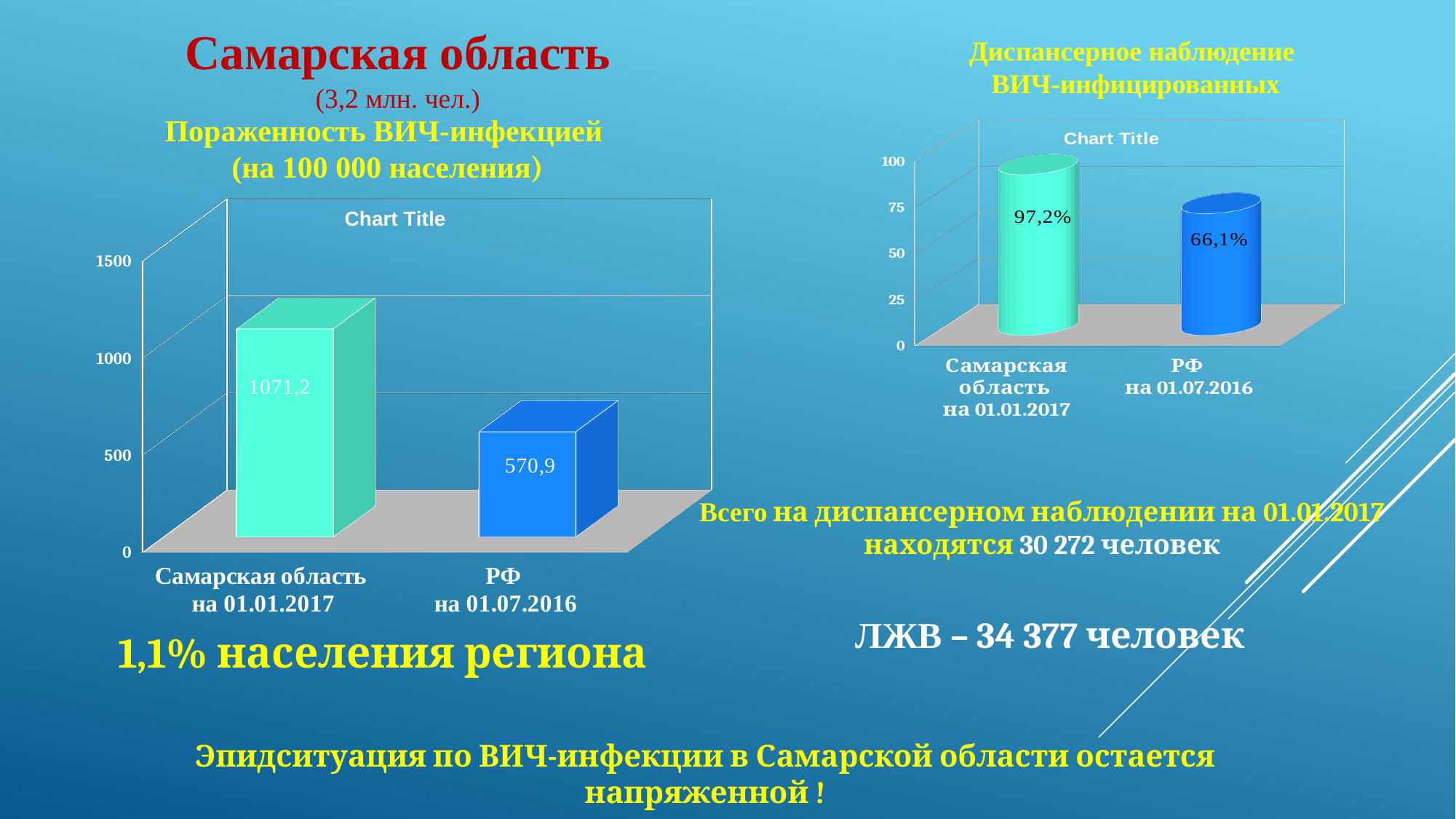
In the right chart (Диспансерное наблюдение ВИЧ-инфицированных), what is the difference between the value for Самарская область and the value for РФ? 31,1% In the left chart (Пораженность ВИЧ-инфекцией), is the value for РФ на 01.07.2016 greater or less than 1000? less In the right chart (Диспансерное наблюдение ВИЧ-инфицированных), what is the value for Самарская область на 01.01.2017? 97,2% In the left chart (Пораженность ВИЧ-инфекцией), what is the value for Самарская область на 01.01.2017? 1071,2 In the right chart (Диспансерное наблюдение ВИЧ-инфицированных), is the value for Самарская область greater or less than 75? greater In the left chart (Пораженность ВИЧ-инфекцией), what is the difference between the value for Самарская область and the value for РФ? 500,3 In the right chart (Диспансерное наблюдение ВИЧ-инфицированных), which category has the lower value? РФ на 01.07.2016 In the left chart (Пораженность ВИЧ-инфекцией), which category has the higher value? Самарская область на 01.01.2017 In the left chart (Пораженность ВИЧ-инфекцией), what is the value for РФ на 01.07.2016? 570,9 How many categories are shown in the left chart (Пораженность ВИЧ-инфекцией)? 2 What kind of chart is the right chart (Диспансерное наблюдение ВИЧ-инфицированных)? bar chart In the right chart (Диспансерное наблюдение ВИЧ-инфицированных), what is the value for РФ на 01.07.2016? 66,1%